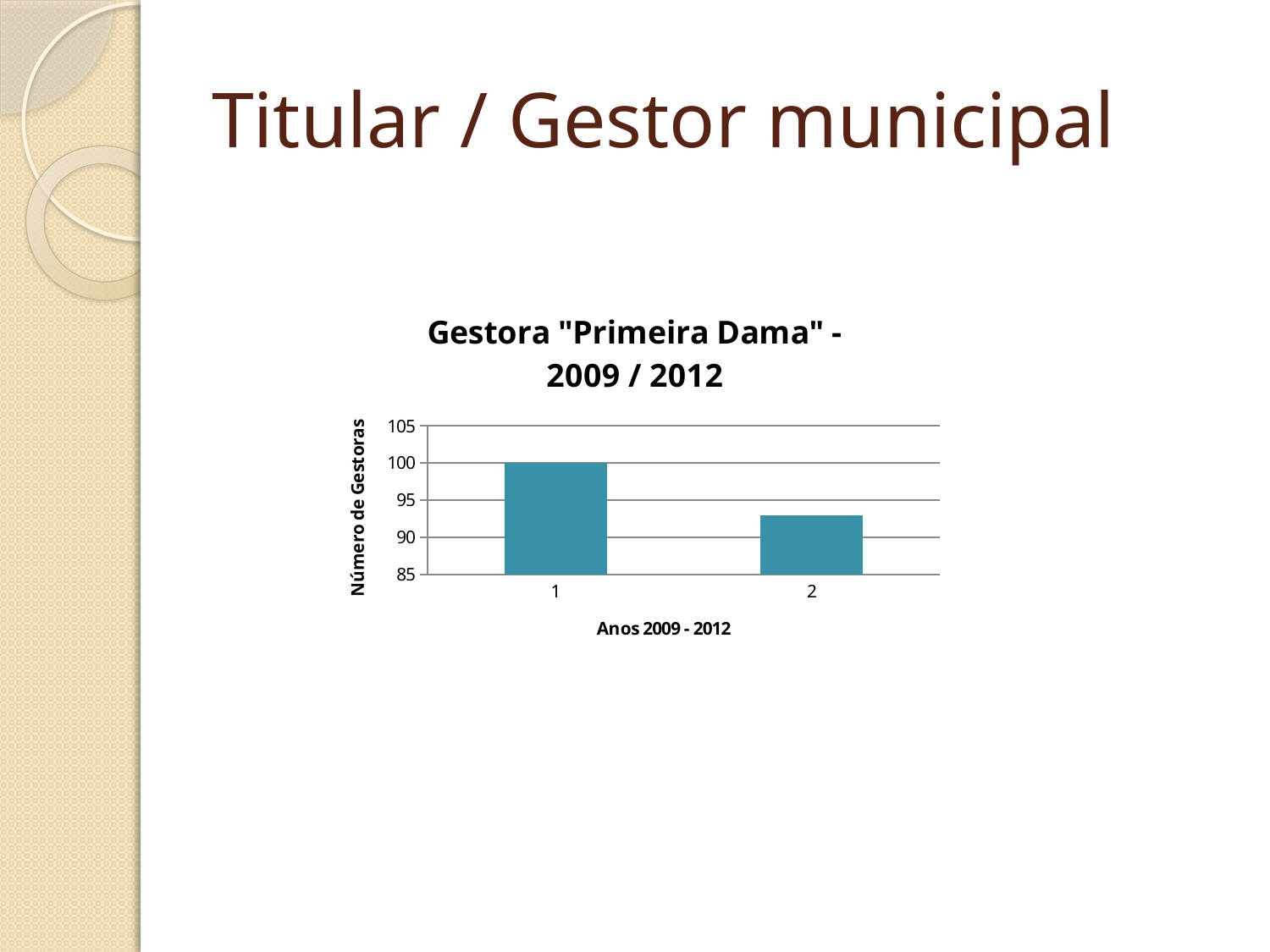
Is the value for category 2 greater or less than 90? greater Do the values rise or fall from category 1 to category 2? fall Which is larger, the value for category 1 or category 2? category 1 What is the label of the vertical axis? Número de Gestoras Which category has the lowest value? 2 Is the value for category 2 greater or less than 95? less How many bars are plotted in the chart? 2 What is the title of the chart? Gestora "Primeira Dama" - 2009 / 2012 What is the value for category 1? 100 Which category has the highest value? 1 What type of chart is shown on the slide? bar chart